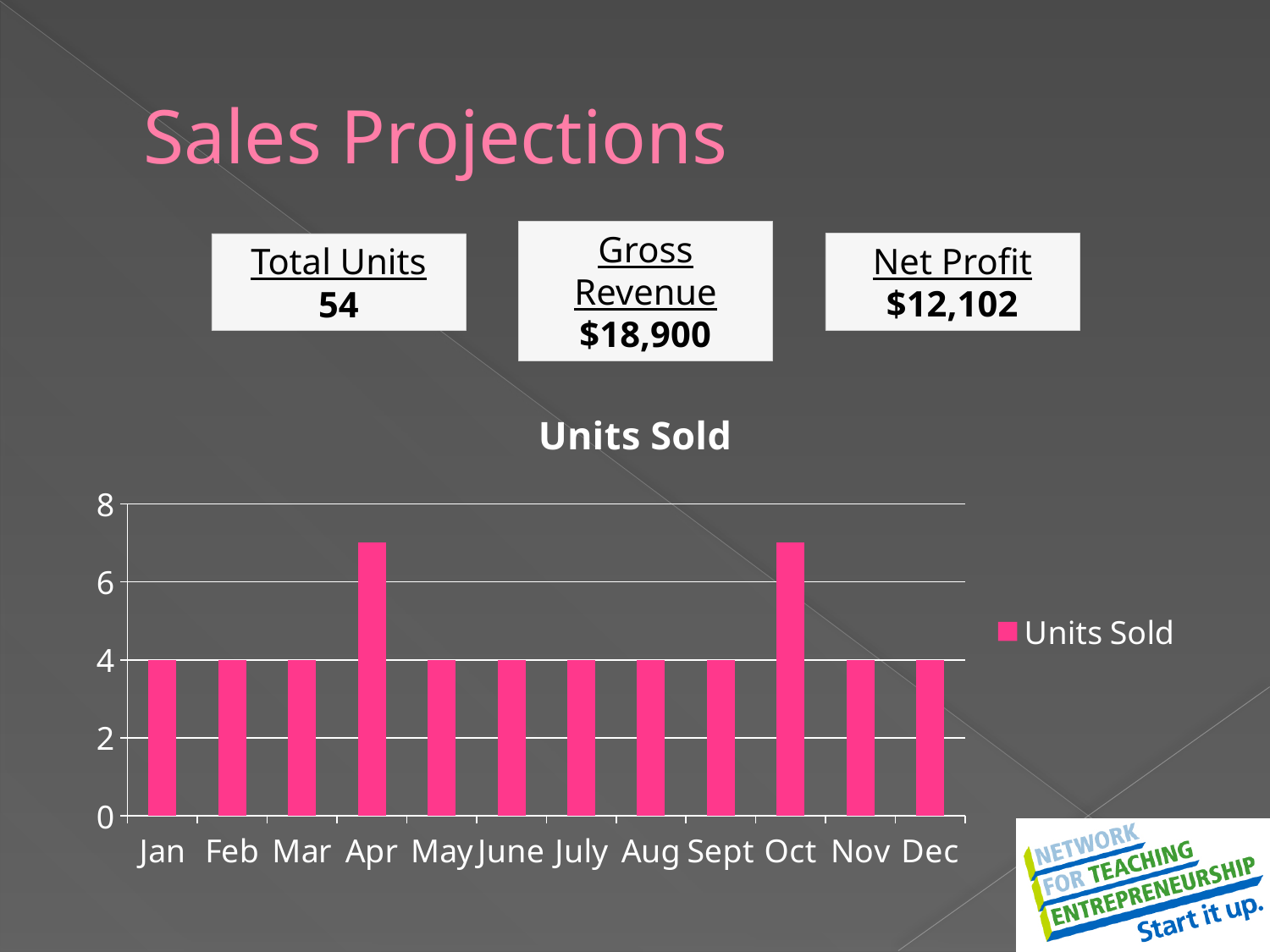
How many months are shown on the x axis of the chart? 12 Which is larger, the value for Apr or the value for Mar? Apr Is the value for Sept greater or less than 6? less What is the value for Jan in the Units Sold chart? 4 What kind of chart is shown on the slide? bar chart Which is larger, the value for Nov or the value for Oct? Oct What is the title of the chart? Units Sold Is the value for Oct greater or less than 8? less What is the value for June in the Units Sold chart? 4 How many series does the legend list? 1 Is the value for Apr greater or less than 6? greater What is the value for Dec in the Units Sold chart? 4